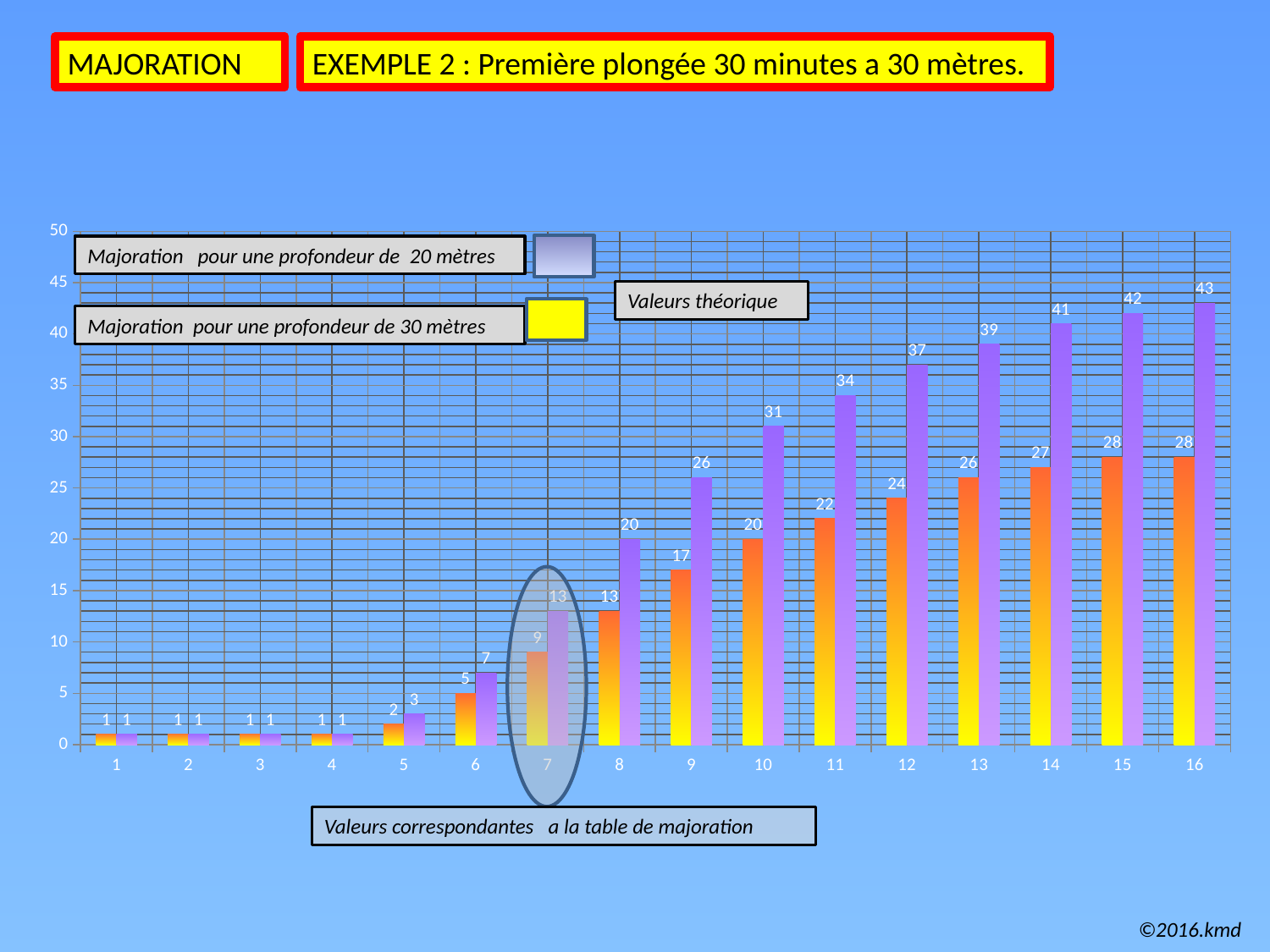
What is the value of the 'Majoration pour une profondeur de 30 mètres' series at category 7? 9 Do the values of the 'Majoration pour une profondeur de 30 mètres' series rise or fall from category 1 to category 16? rise Which is larger at category 9: the 20 mètres value or the 30 mètres value? 20 mètres value What is the difference between the 20 mètres and 30 mètres values at category 12? 13 What kind of chart is shown on the slide? bar chart At which category is the 'Majoration pour une profondeur de 20 mètres' series highest? 16 Is the value of the 20 mètres series at category 13 greater or less than 35? greater How many categories are shown along the x axis? 16 How many series does the legend list? 2 What is the value of the 'Majoration pour une profondeur de 20 mètres' series at category 10? 31 What is the value of the 'Majoration pour une profondeur de 20 mètres' series at category 16? 43 Which colour represents the 'Majoration pour une profondeur de 30 mètres' series in the legend? yellow